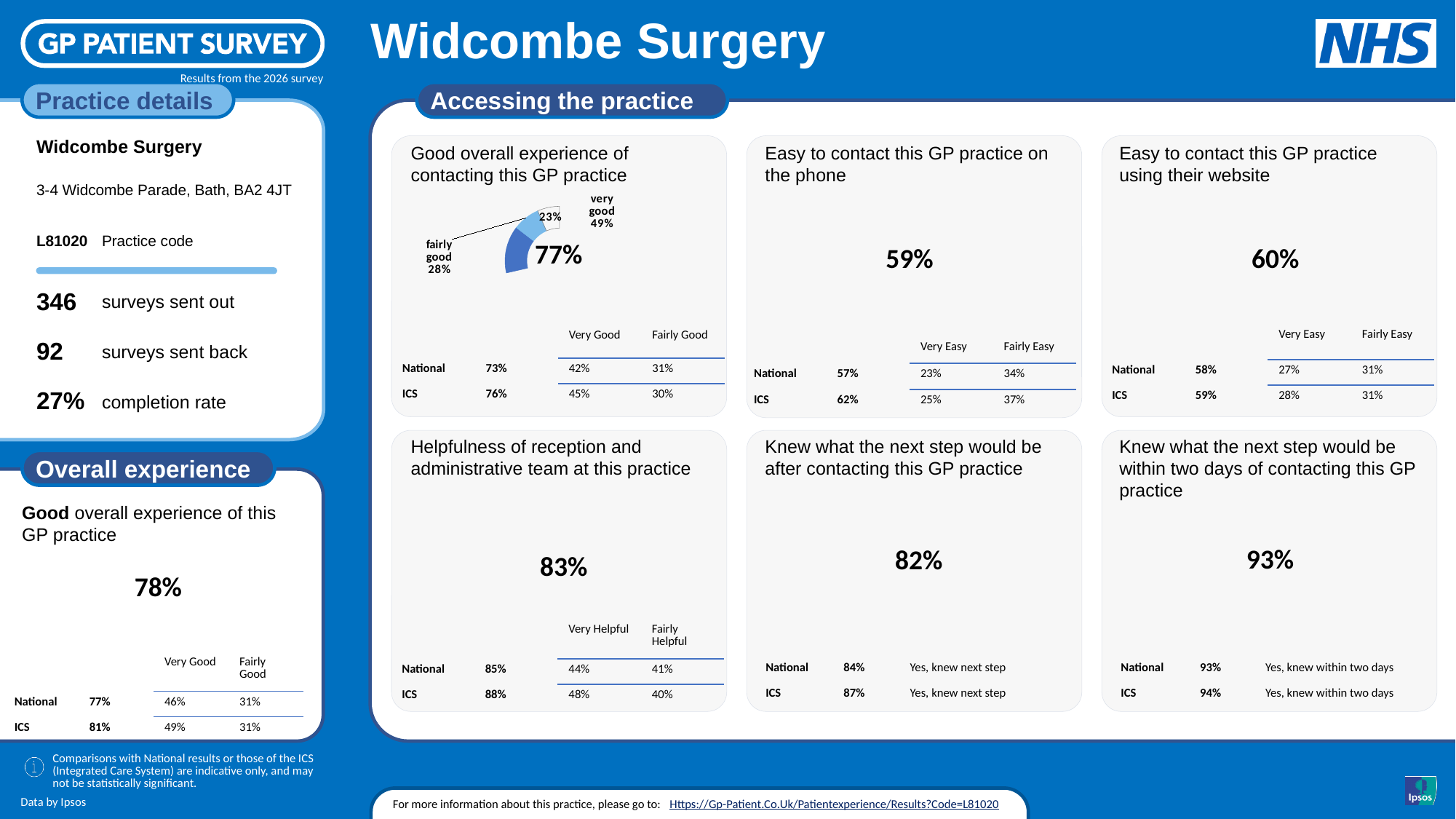
In the 'Good overall experience of contacting this GP practice' chart, is the 'very good' share greater or less than 40%? greater What is the title of the panel containing the pie chart on this slide? Good overall experience of contacting this GP practice What value is printed in the centre of the 'Good overall experience of contacting this GP practice' chart? 77% In the 'Good overall experience of contacting this GP practice' chart, what do the 'very good' and 'fairly good' slices add up to? 77% In the 'Good overall experience of contacting this GP practice' chart, what is the smallest percentage label shown on a slice? 23% In the 'Good overall experience of contacting this GP practice' chart, what percentage is labelled 'fairly good'? 28% What kind of chart is shown in the 'Good overall experience of contacting this GP practice' panel? pie chart How many slices carry a percentage label in the 'Good overall experience of contacting this GP practice' chart? 3 In the 'Good overall experience of contacting this GP practice' chart, which labelled slice is larger: 'very good' or 'fairly good'? very good In the 'Good overall experience of contacting this GP practice' chart, what percentage is labelled 'very good'? 49% In the 'Good overall experience of contacting this GP practice' chart, what is the difference between the 'very good' and 'fairly good' percentages? 21 percentage points